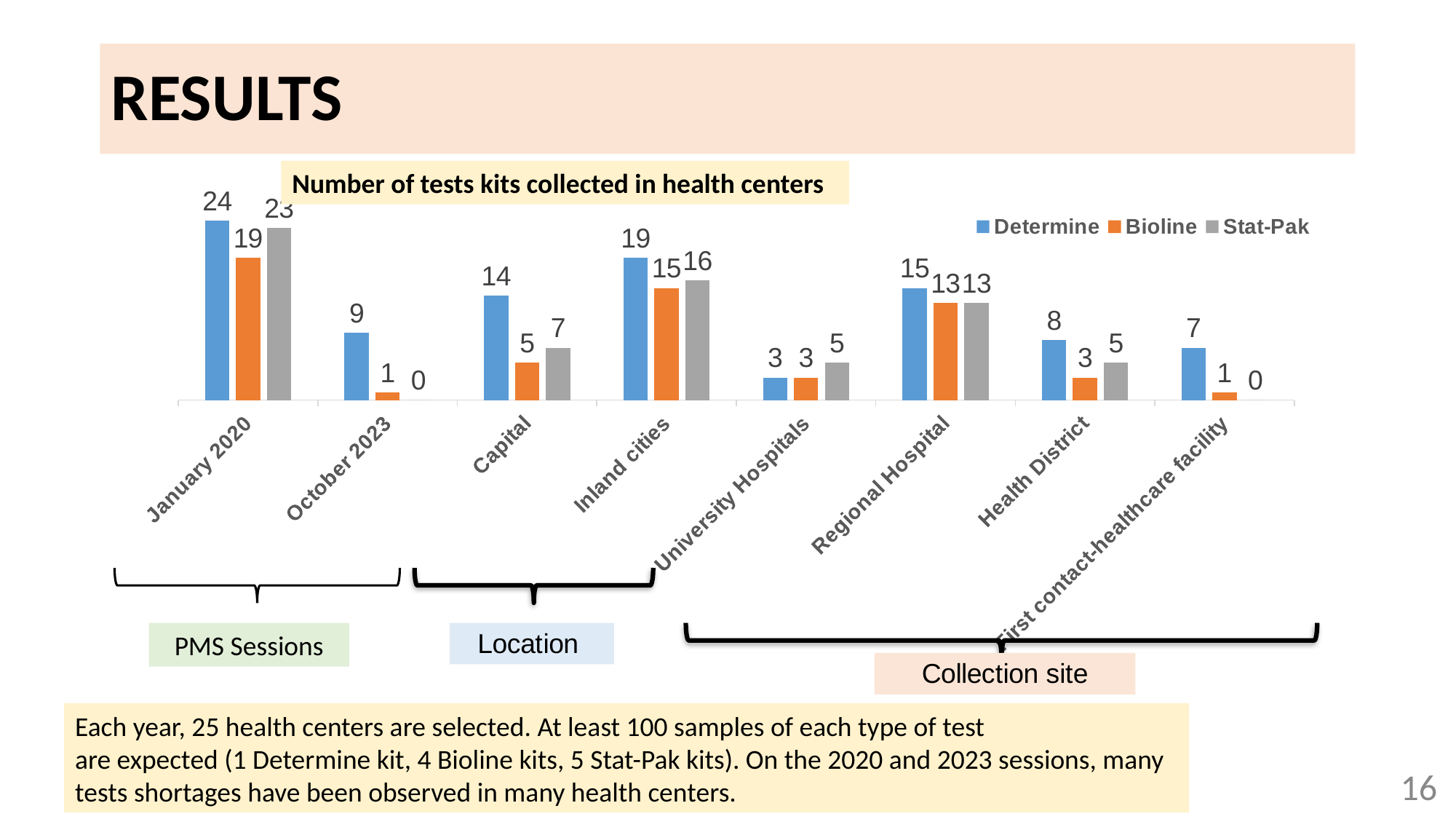
What is the title of the chart? Number of tests kits collected in health centers How many series does the legend list? 3 What is the Bioline value for Inland cities? 15 Which is larger for Regional Hospital, the Determine value or the Bioline value? Determine What is the Stat-Pak value for Health District? 5 Which category has the lowest Determine value? University Hospitals What is the Bioline value for October 2023? 1 What kind of chart is shown? Bar chart What is the difference between the Determine and Bioline values for Capital? 9 How many categories are shown on the x axis? 8 Which category has the highest Determine value? January 2020 What is the Determine value for January 2020? 24